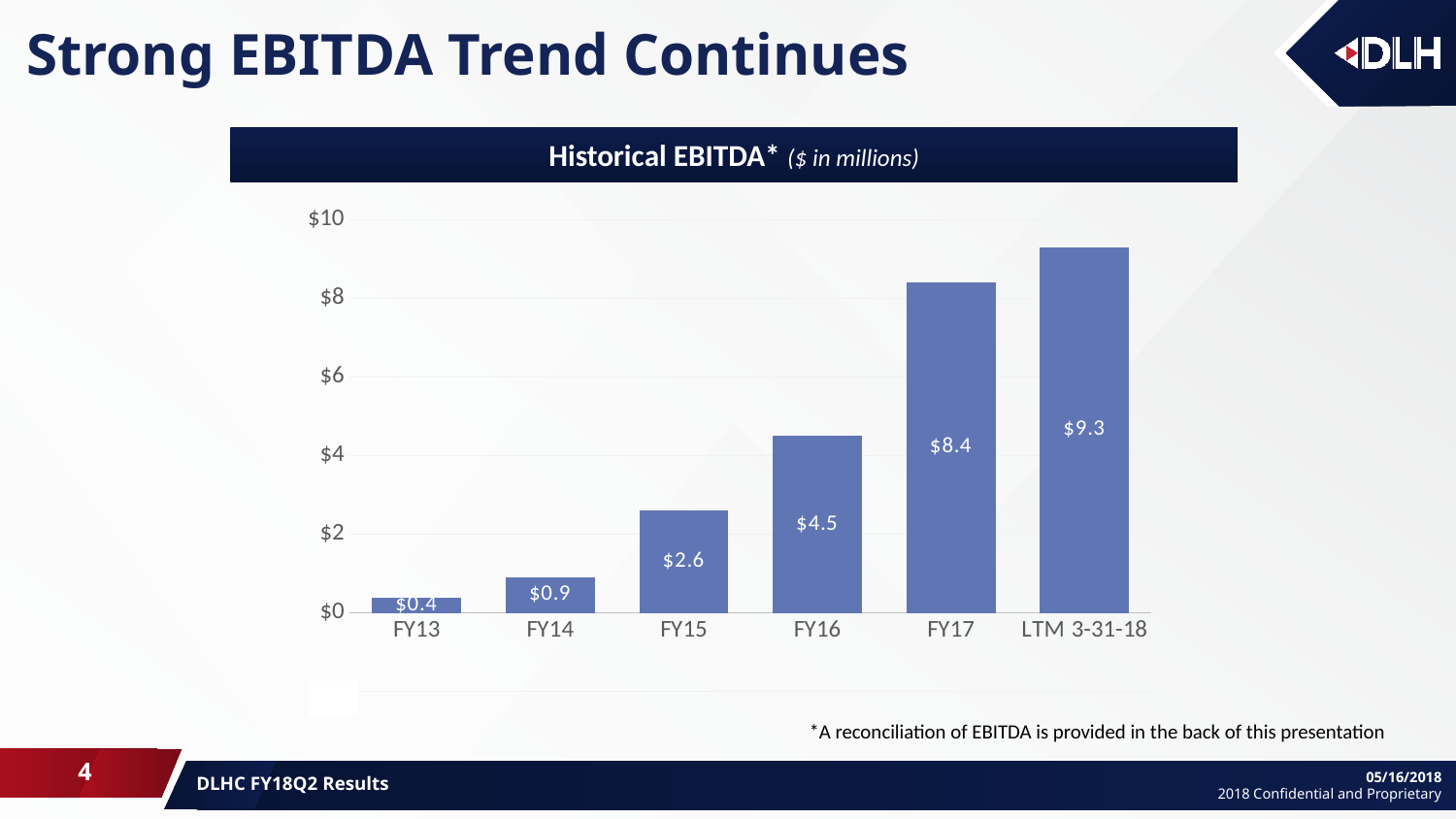
What is the difference in EBITDA between LTM 3-31-18 and FY13? $8.9 What is the EBITDA value for FY16? $4.5 What is the difference in EBITDA between FY17 and FY16? $3.9 Do the EBITDA values rise or fall from FY13 to LTM 3-31-18? Rise Which period has the lowest EBITDA? FY13 Which period has the highest EBITDA? LTM 3-31-18 Is the EBITDA value for FY17 greater or less than $8? greater How many periods are shown on the chart? 6 What is the EBITDA value for FY13? $0.4 What kind of chart is shown on the slide? Bar chart What is the EBITDA value for LTM 3-31-18? $9.3 Which is larger, the EBITDA for FY15 or FY14? FY15